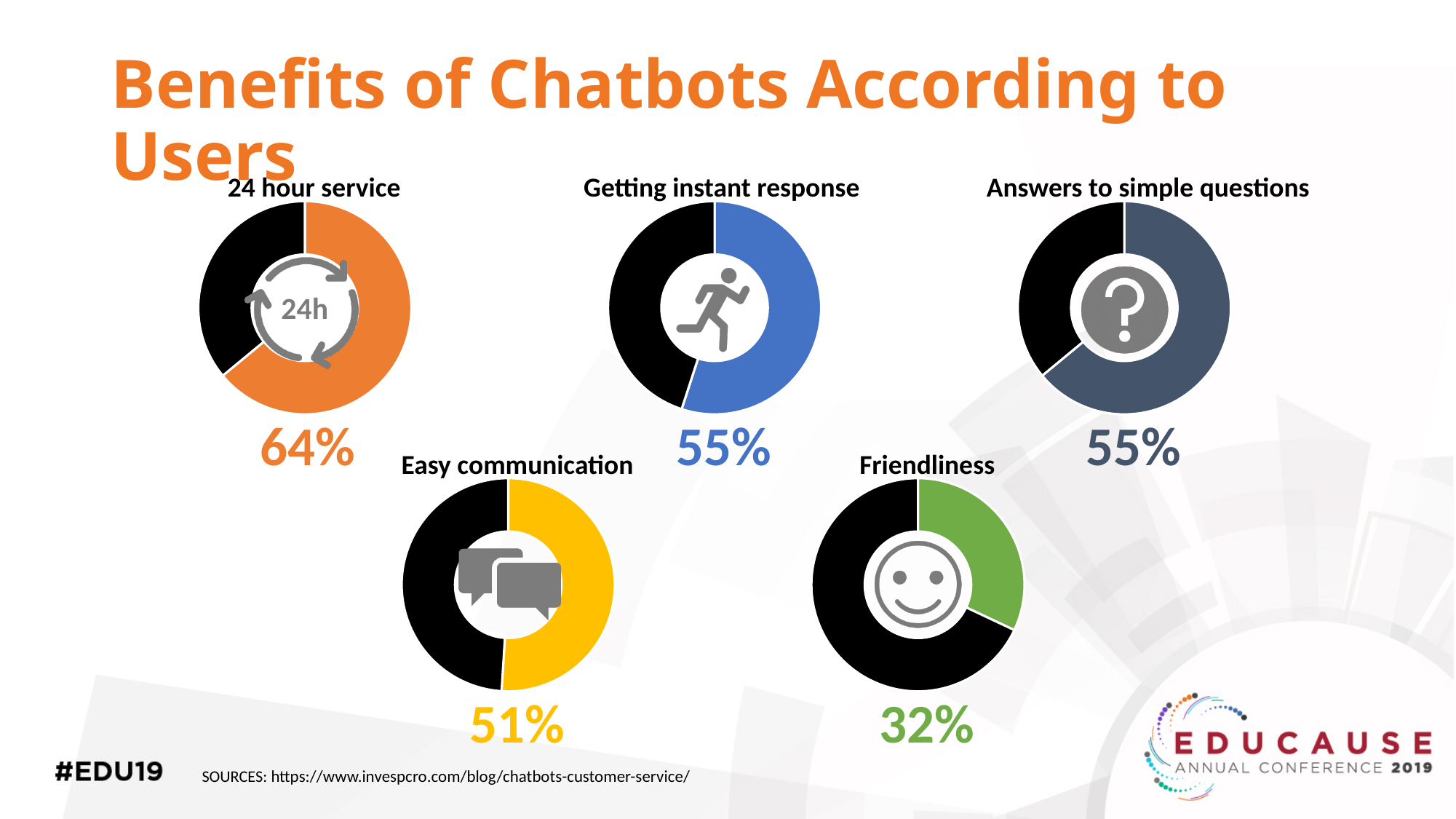
What percentage is shown for the "Answers to simple questions" chart? 55% What percentage is shown for the "24 hour service" chart? 64% What percentage is shown for the "Easy communication" chart? 51% What is the difference between the "24 hour service" percentage and the "Friendliness" percentage? 32% What percentage is shown for the "Getting instant response" chart? 55% How many donut charts are shown on the slide? 5 Which benefit has the highest percentage across the charts on the slide? 24 hour service Which benefit has the lowest percentage across the charts on the slide? Friendliness What percentage is shown for the "Friendliness" chart? 32% Which is larger, the percentage for "Easy communication" or the percentage for "Friendliness"? Easy communication What colour is the highlighted segment in the "Friendliness" chart? Green What kind of chart is used for each benefit on the slide? Donut (pie) chart